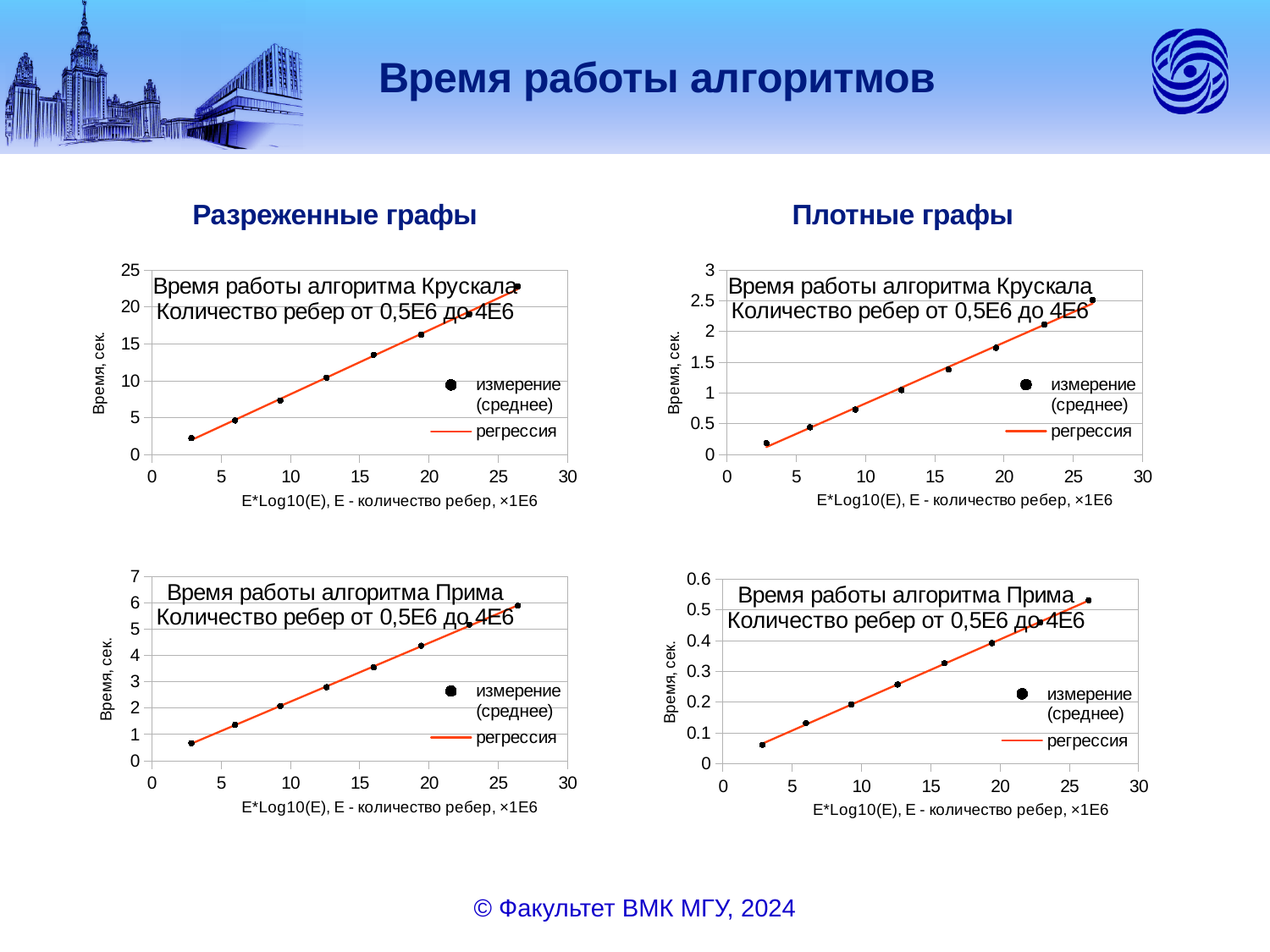
What is the x-axis label of the top-right chart (Крускала, Плотные графы)? E*Log10(E), E - количество ребер, ×1E6 In the top-right chart (Крускала, Плотные графы), is the time for the rightmost measurement point greater or less than 2 seconds? greater How many series does the legend of the top-left chart (Крускала, Разреженные графы) list? 2 In the top-left chart (Крускала, Разреженные графы), is the time for the rightmost measurement point greater or less than 20 seconds? greater What are the two legend entries in the bottom-right chart (Прима, Плотные графы)? измерение (среднее), регрессия How many measurement points are plotted in the top-left chart (Крускала, Разреженные графы)? 8 In the bottom-right chart (Прима, Плотные графы), is the time for the leftmost measurement point greater or less than 0.1 seconds? less What kind of chart is the top-left chart (Время работы алгоритма Крускала, Разреженные графы)? scatter chart with a regression line In the top-left chart (Крускала, Разреженные графы), does the running time rise or fall as E*Log10(E) increases? rise How many measurement points are plotted in the bottom-right chart (Прима, Плотные графы)? 8 In the bottom-right chart (Прима, Плотные графы), does the running time rise or fall along the x axis? rise